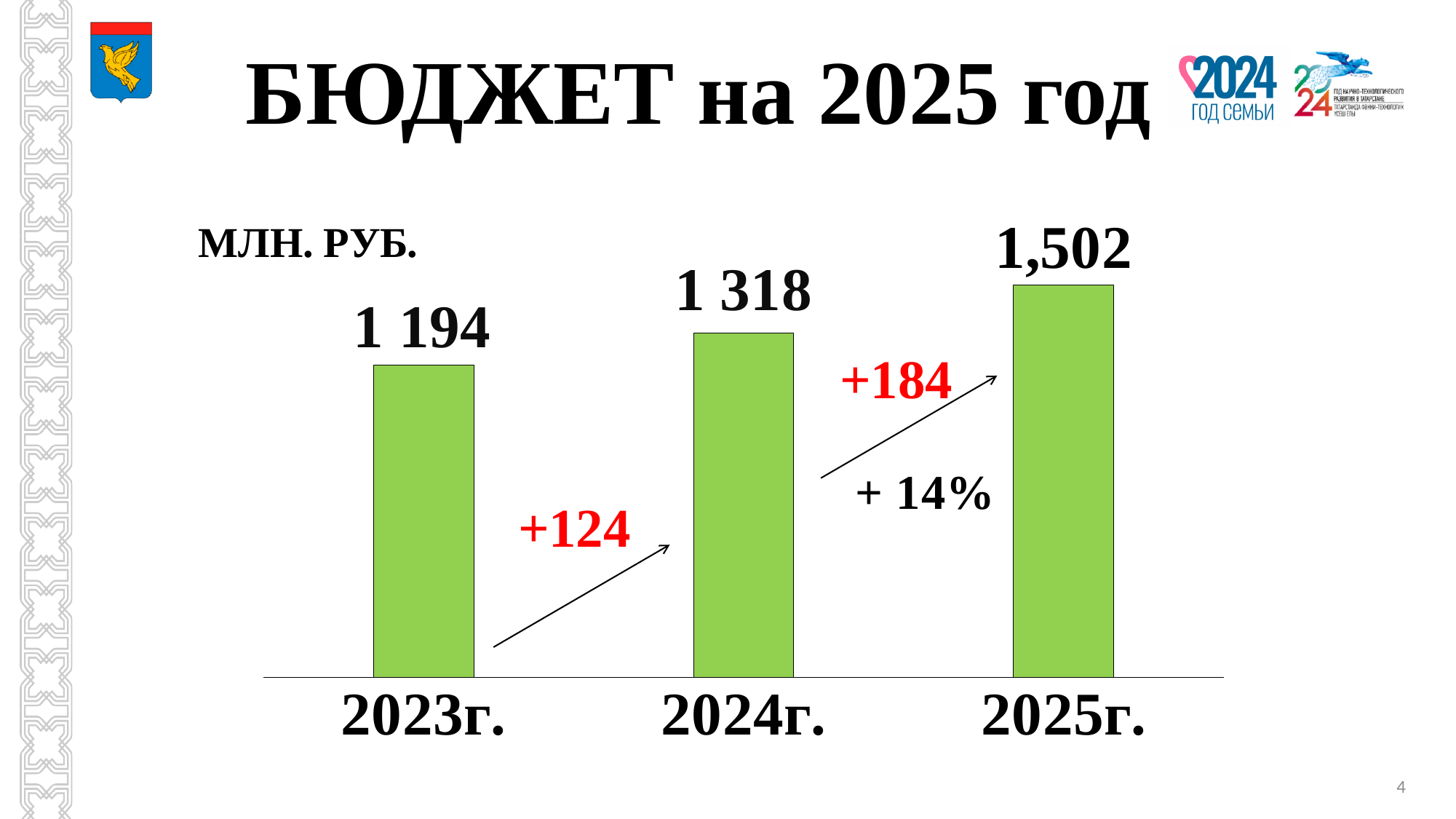
Do the budget values rise or fall from 2023г. to 2025г.? Rise What is the increase from 2024г. to 2025г. as labelled on the chart? +184 What is the budget value shown for 2025г.? 1,502 What is the difference between the 2025г. and 2023г. budget values? 308 What kind of chart is shown on the slide? Bar chart How many years (bars) are shown on the chart? 3 Which year has the lowest budget value? 2023г. What is the budget value shown for 2024г.? 1 318 Which year has the highest budget value? 2025г. What is the budget value shown for 2023г.? 1 194 What is the increase from 2023г. to 2024г. as labelled on the chart? +124 Which is larger, the budget for 2024г. or for 2025г.? 2025г.